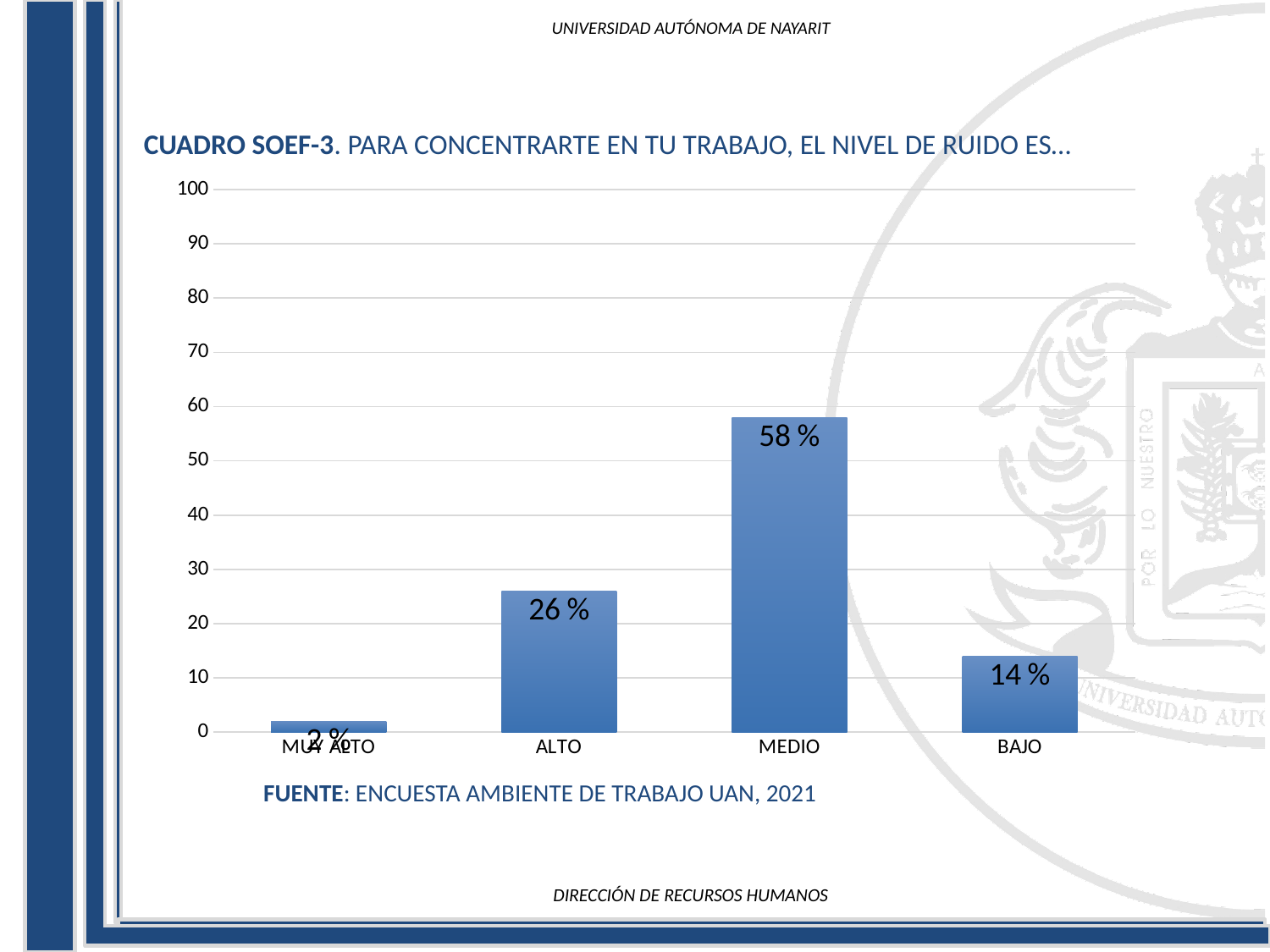
What is the value shown for the ALTO category? 26 % What is the difference between the MEDIO and ALTO values? 32 % Is the value for MEDIO greater or less than 50? greater What is the difference between the ALTO and BAJO values? 12 % How many categories are shown on the x axis? 4 Which is larger, the value for ALTO or the value for BAJO? ALTO What percentage of respondents answered MEDIO? 58 % What kind of chart is shown on the slide? bar chart Which category has the lowest value? MUY ALTO What source is cited below the chart? ENCUESTA AMBIENTE DE TRABAJO UAN, 2021 Which category has the highest value? MEDIO What is the value shown for the BAJO category? 14 %